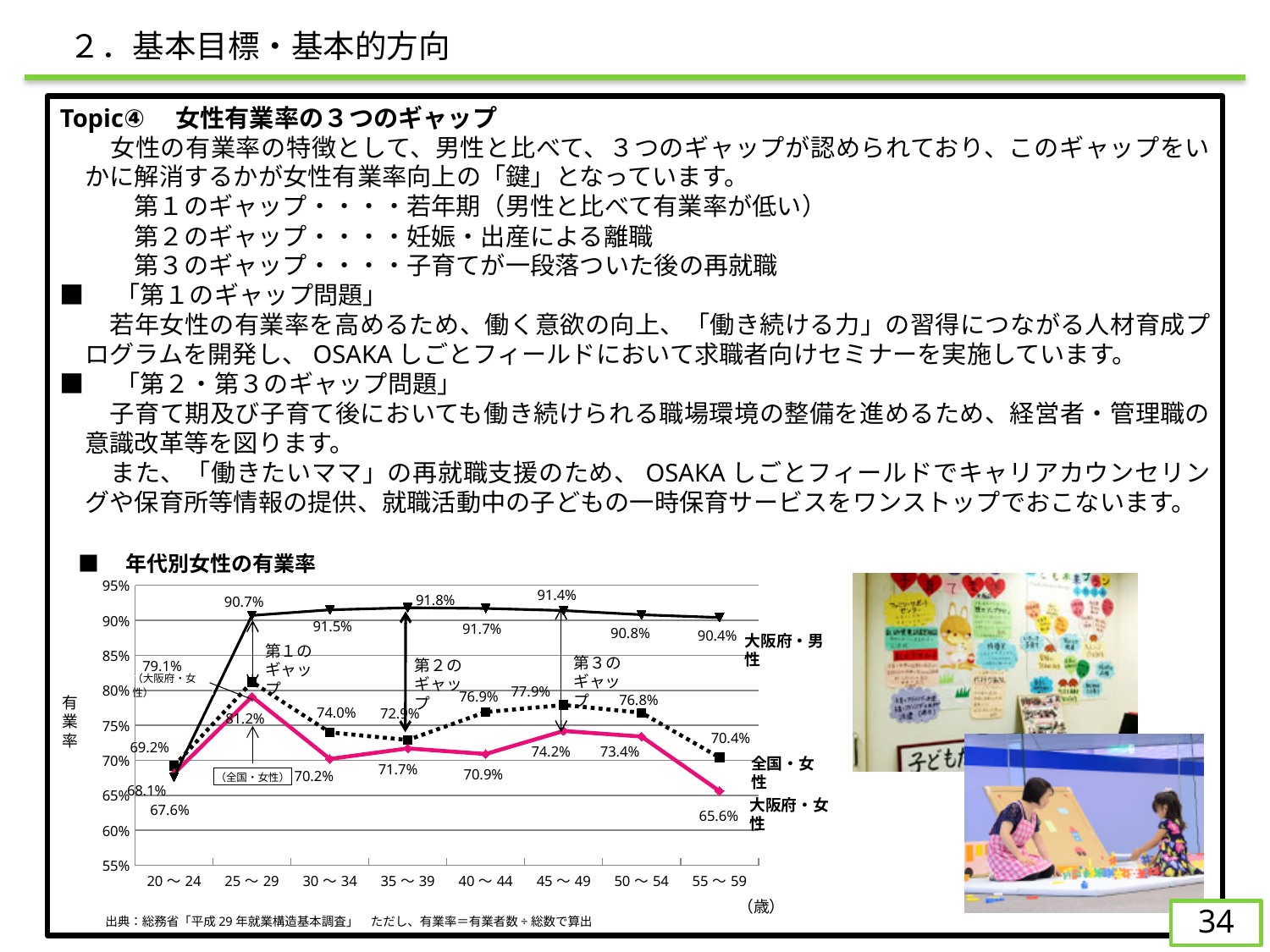
What is the value for 全国・女性 in the 45～49 age group? 77.9% In which age group is the 大阪府・女性 series at its lowest? 55～59 Does the 大阪府・男性 series rise or fall from 25～29 to 35～39? rise What is the value for 大阪府・女性 in the 55～59 age group? 65.6% What is the difference between 大阪府・男性 and 全国・女性 in the 35～39 age group? 18.9% How many series does the chart's legend list? 3 What is the value for 大阪府・男性 in the 35～39 age group? 91.8% Is the value for 大阪府・女性 in the 45～49 age group greater or less than 80%? less What kind of chart is shown on the slide? line chart Which is larger in the 30～34 age group: 全国・女性 or 大阪府・女性? 全国・女性 In which age group is the 全国・女性 series at its highest? 25～29 How many age groups are plotted along the x axis? 8